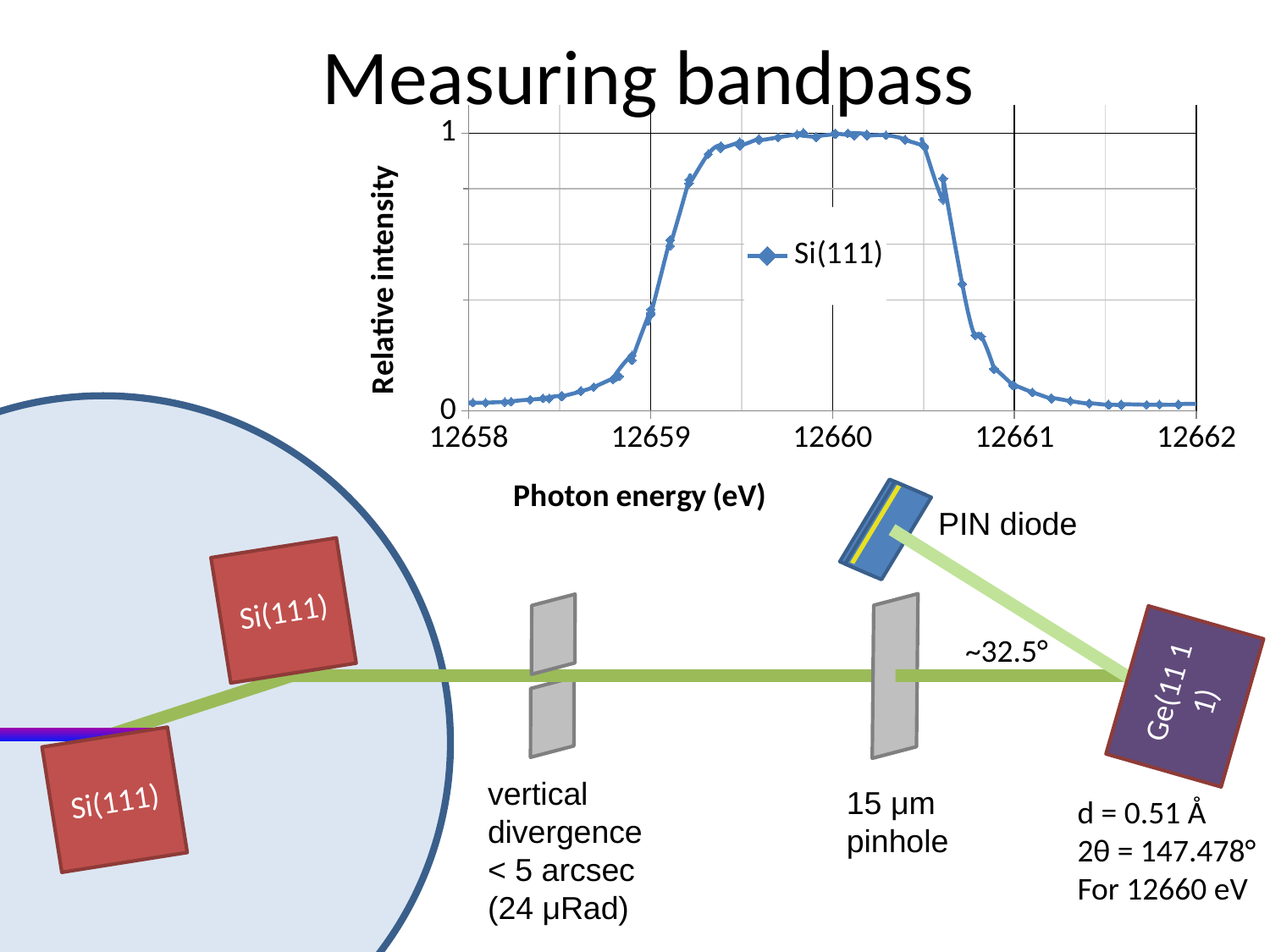
Which has the larger relative intensity: the point at 12660 eV or the point at 12658 eV? 12660 eV At which labeled x-axis tick does the Si(111) curve reach its highest relative intensity? 12660 Does the relative intensity rise or fall as photon energy increases from 12658 eV to 12660 eV? rise How many series does the chart legend list? 1 Is the relative intensity at a photon energy of 12658 eV greater or less than 0.5? less What is the name of the series shown in the chart legend? Si(111) What kind of chart is shown on the slide? line chart What is the title of the chart's x axis? Photon energy (eV) Is the relative intensity at a photon energy of 12660 eV greater or less than 0.5? greater Does the relative intensity rise or fall as photon energy increases from 12660 eV to 12662 eV? fall Is the relative intensity at a photon energy of 12661 eV greater or less than 0.5? less